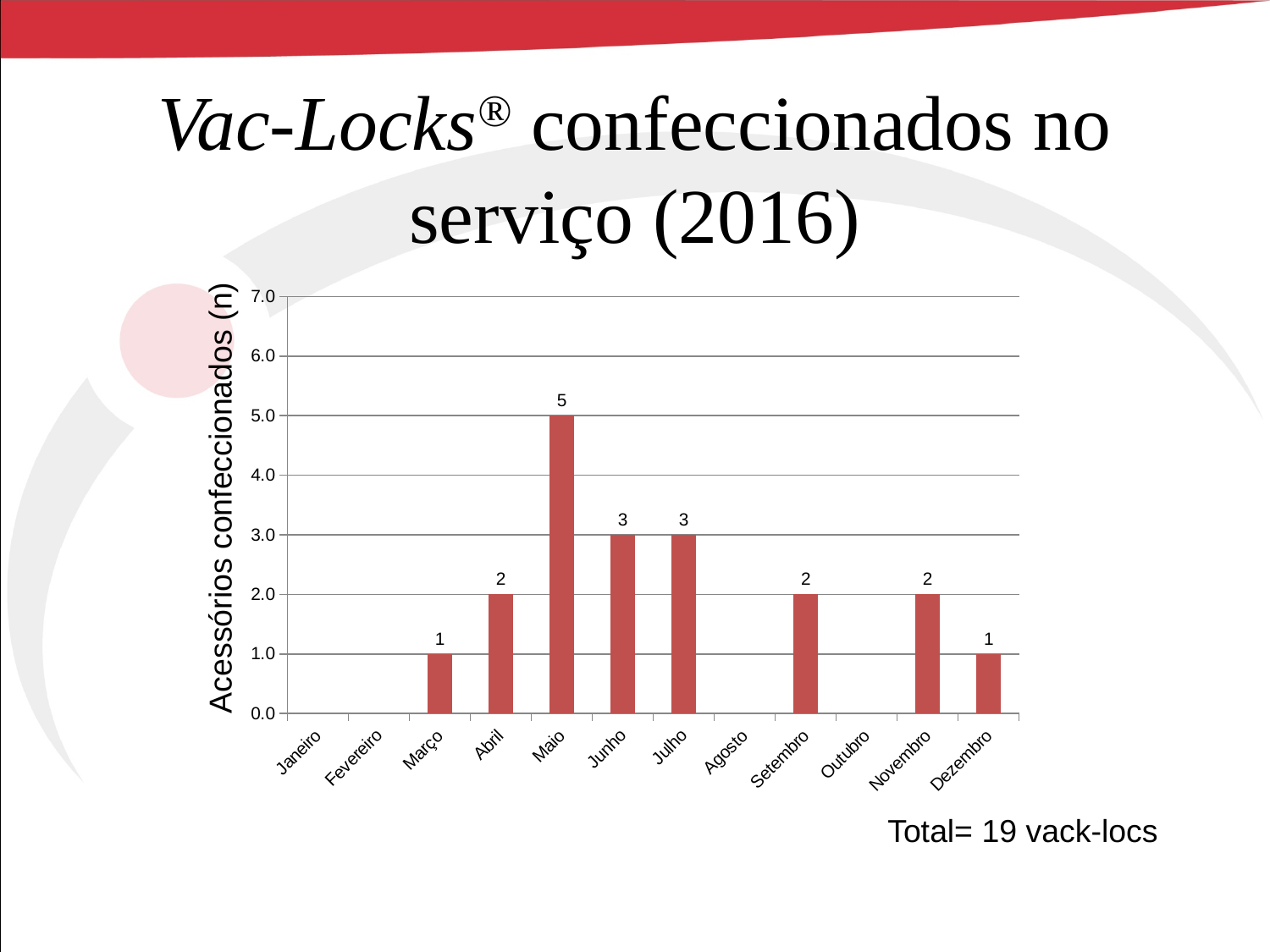
What is the value for Setembro? 2 Is the value for Maio greater or less than 4.0? greater Do the values rise or fall from Março to Maio? rise What is the label of the y axis? Acessórios confeccionados (n) What is the difference between the values for Maio and Junho? 2 What total is stated below the chart? Total= 19 vack-locs What is the value for Maio? 5 What kind of chart is shown on the slide? bar chart What is the value for Dezembro? 1 Which is larger, the value for Abril or the value for Julho? Julho Which month has the highest value? Maio How many months are shown on the x axis? 12